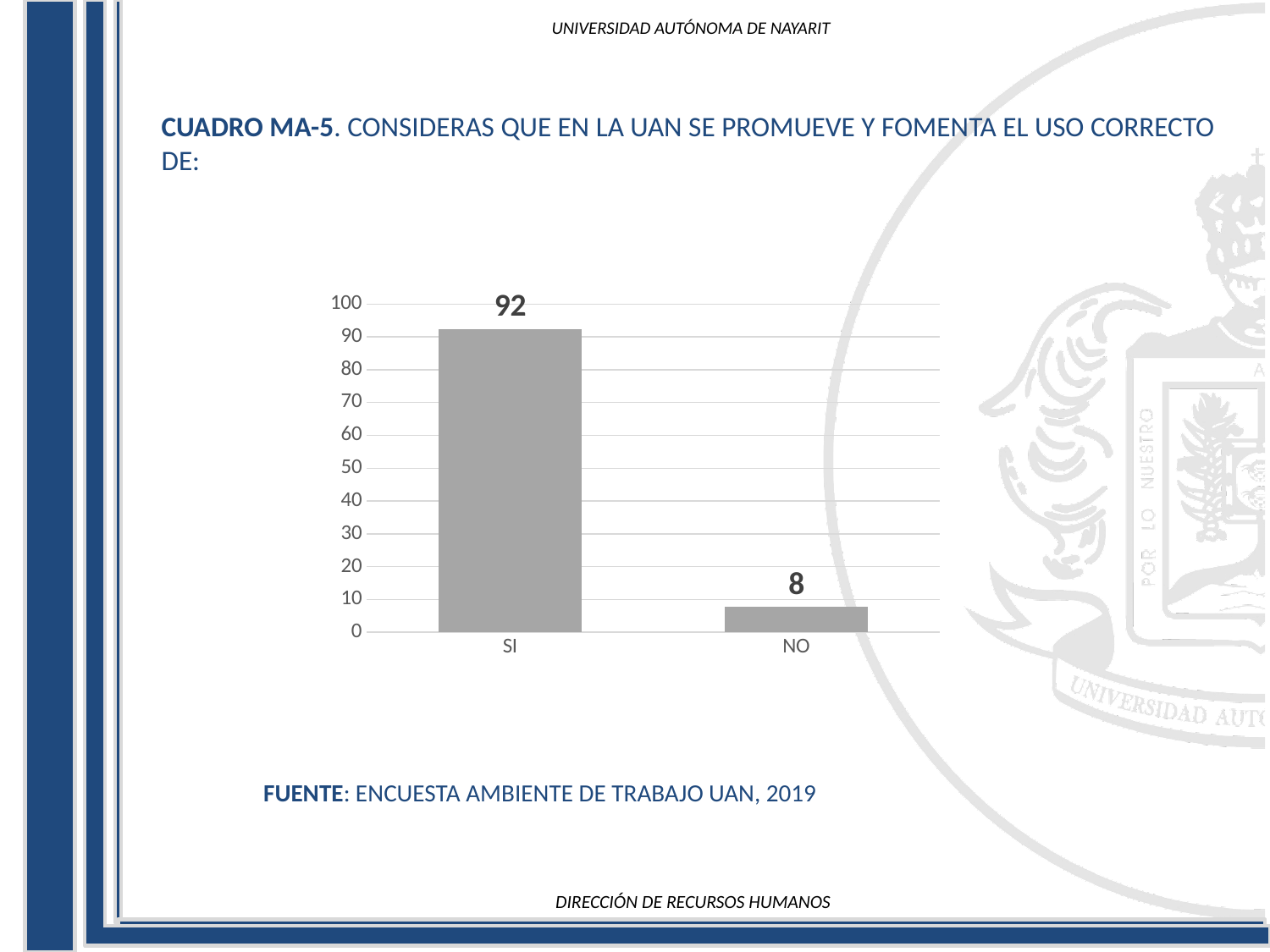
Is the value for NO greater or less than 10? less What is the highest value shown on the y axis? 100 What is the value for SI? 92 Is the value for SI greater or less than 50? greater What is the value for NO? 8 Which is larger, the value for SI or the value for NO? SI What is the difference between the values for SI and NO? 84 What kind of chart is shown on the slide? bar chart Which category has the lowest value? NO How many categories are shown on the x axis? 2 What is the total of the two values shown in the chart? 100 Which category has the highest value? SI